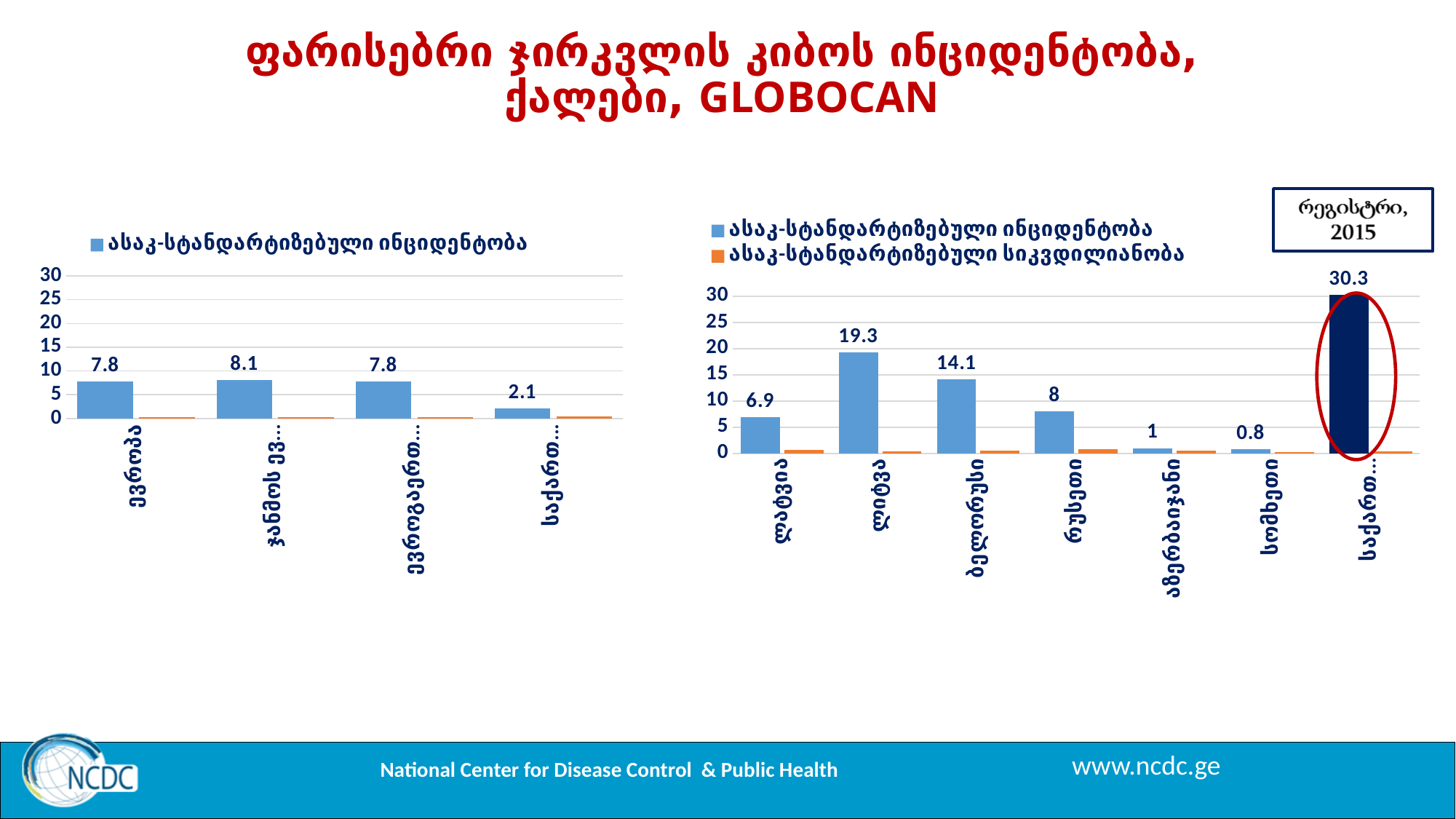
In the left chart, which category has the highest value? ჯანმოს ევ... In the right chart, which category has the highest value? საქართ... In the right chart, what is the value for ბელორუსია? 14.1 In the right chart, what is the value for ლიტვა? 19.3 What kind of chart is the right chart? bar chart In the right chart, which category has the lowest value? სომხეთი In the right chart, what is the difference between the values for ლიტვა and ლატვია? 12.4 In the left chart, what is the value for ევროპა? 7.8 How many series does the legend of the right chart list? 2 In the left chart, how many categories are shown on the x axis? 4 In the right chart, which is larger, the value for რუსეთი or the value for ლატვია? რუსეთი In the left chart, which category has the lowest value? საქართ...